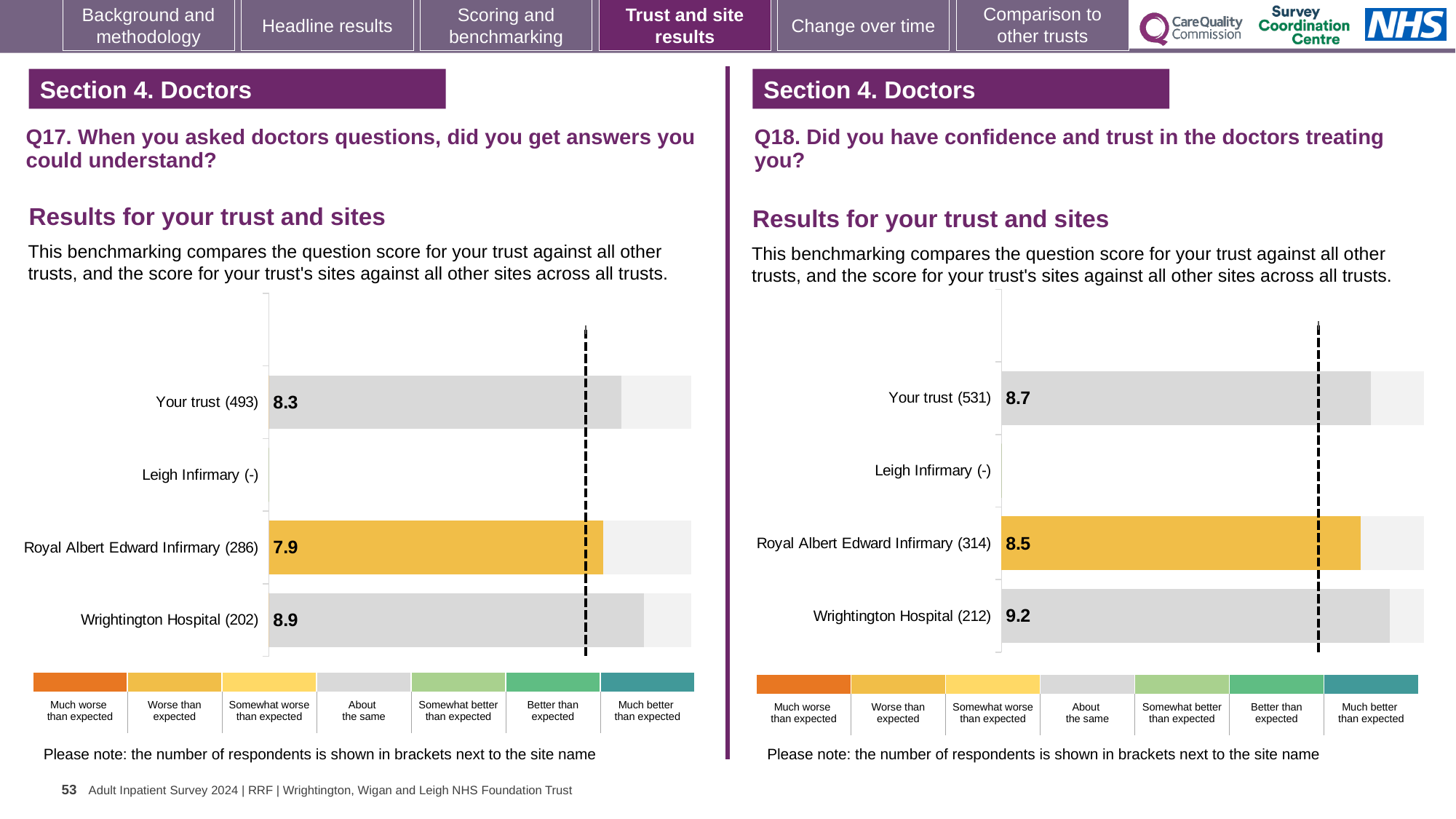
On the Q18 chart (right), which is larger, the score for Your trust or the score for Royal Albert Edward Infirmary? Your trust On the Q17 chart (left), how many respondents are shown for Royal Albert Edward Infirmary? 286 On the Q17 chart (left), what is the difference between the scores for Wrightington Hospital and Royal Albert Edward Infirmary? 1.0 On the Q18 chart (right), how many respondents are shown for Your trust? 531 On the Q18 chart (right), what is the score for Royal Albert Edward Infirmary? 8.5 On the Q18 chart (right), which site has the highest score? Wrightington Hospital On the Q18 chart (right), what is the difference between the scores for Wrightington Hospital and Your trust? 0.5 On the Q17 chart (left), which site has the lowest score? Royal Albert Edward Infirmary On the Q18 chart (right), which benchmark category does the colour of the Royal Albert Edward Infirmary bar indicate? Worse than expected On the Q17 chart (left), what is the score for Your trust? 8.3 On the Q17 chart (left), what is the score for Wrightington Hospital? 8.9 What kind of chart is used on the Q17 chart (left)? Bar chart